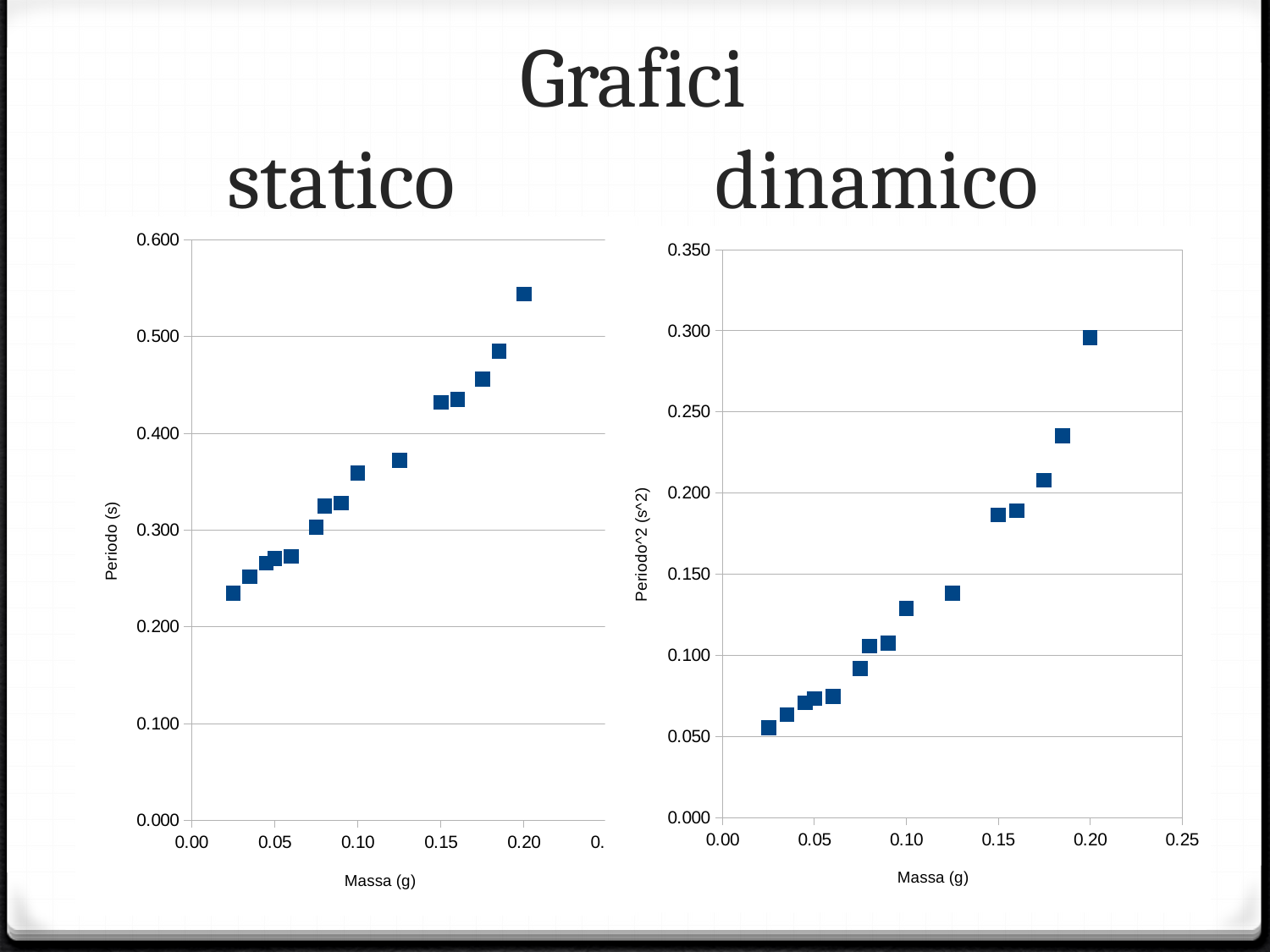
In the 'statico' chart, is the period at mass 0.10 greater or less than 0.400? less In the 'statico' chart, is the period at mass 0.20 greater or less than 0.500? greater What kind of chart is the 'dinamico' chart on the right? scatter chart In the 'dinamico' chart, is the value at mass 0.125 greater or less than 0.150? less In the 'dinamico' chart, do the values rise or fall as mass increases along the x axis? rise What is the y-axis label of the 'dinamico' chart? Periodo^2 (s^2) In the 'statico' chart, at which mass is the period highest? 0.20 What kind of chart is the 'statico' chart on the left? scatter chart What is the x-axis label of the 'statico' chart? Massa (g) In the 'statico' chart, do the values rise or fall as mass increases along the x axis? rise